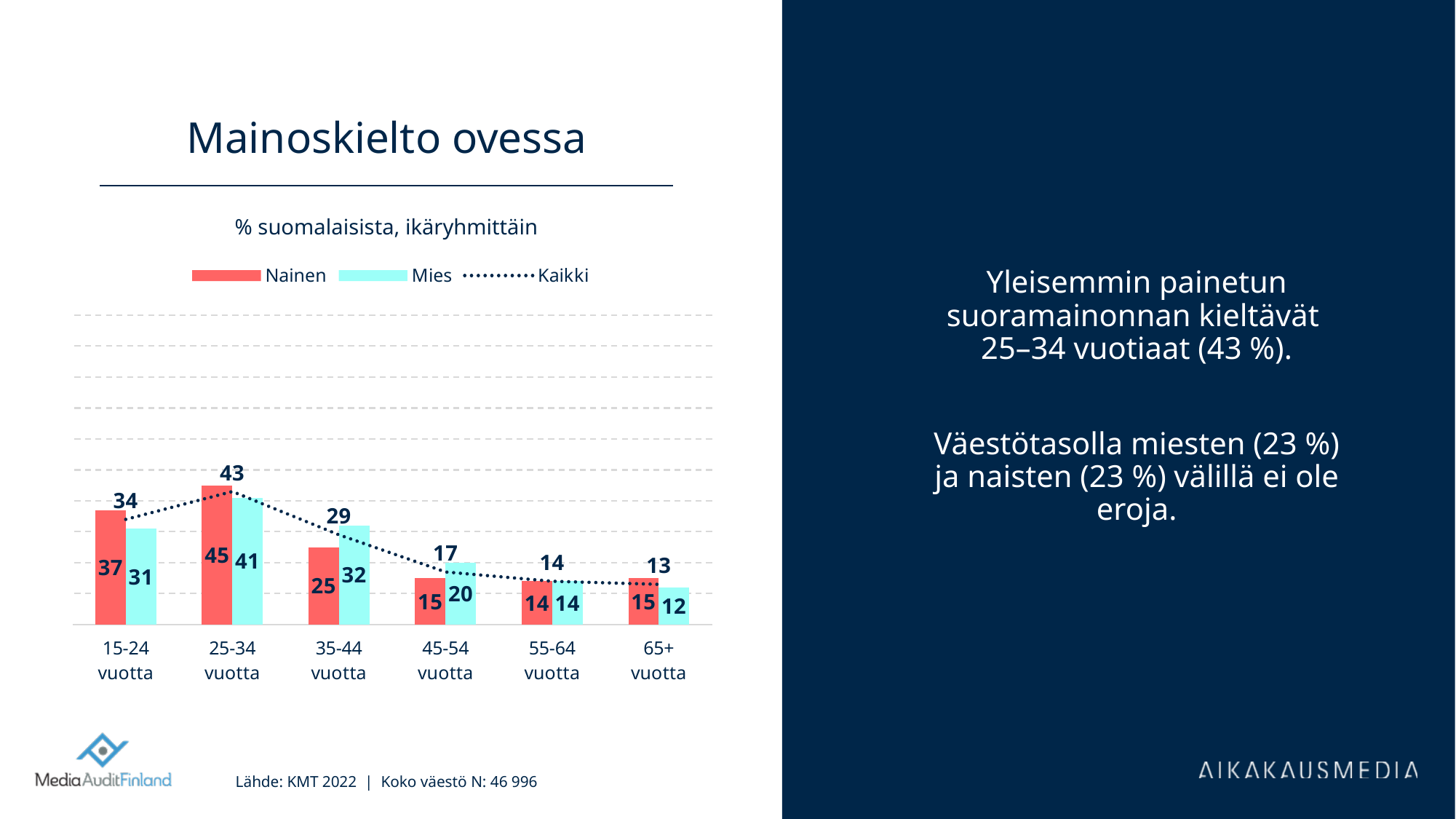
What is the value for Mies in the 35-44 vuotta age group? 32 Which is larger in the 35-44 vuotta age group, the Nainen value or the Mies value? Mies What kind of chart is shown on the slide? Bar chart with a dotted line What is the value for Nainen in the 25-34 vuotta age group? 45 What is the difference between the Nainen and Mies values in the 15-24 vuotta age group? 6 How many age groups are shown on the x axis? 6 Do the Kaikki values rise or fall from the 25-34 vuotta group to the 65+ vuotta group? Fall What is the title of the chart? Mainoskielto ovessa How many series does the legend list? 3 Which age group has the lowest Mies value? 65+ vuotta What is the Kaikki value for the 45-54 vuotta age group? 17 Which age group has the highest Kaikki value? 25-34 vuotta